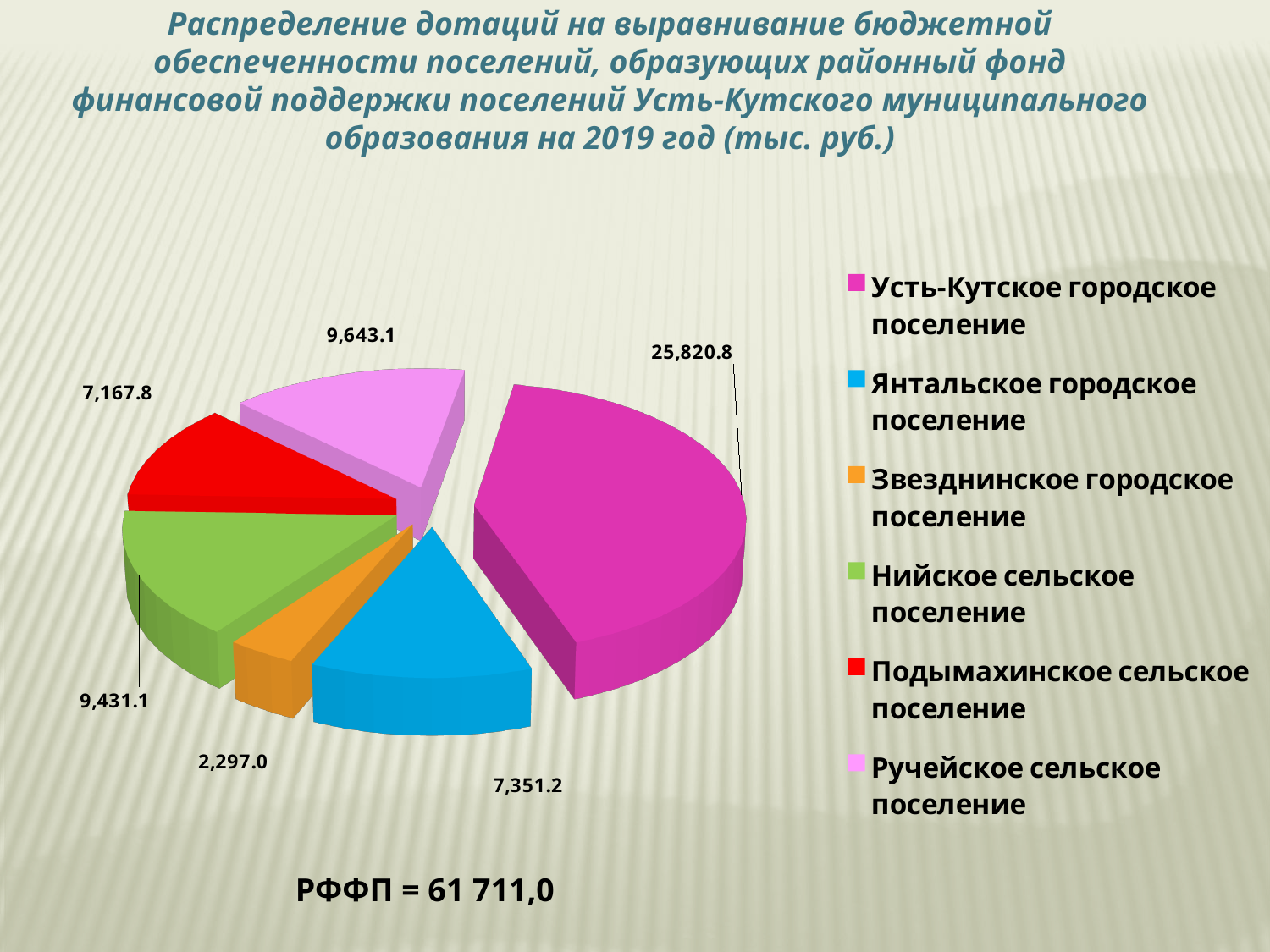
Which settlement receives the largest share of the fund? Усть-Кутское городское поселение What is the value for Нийское сельское поселение? 9,431.1 Which settlement receives the smallest share of the fund? Звезднинское городское поселение How many categories does the legend list? 6 What type of chart is shown on the slide? pie chart What is the value for Янтальское городское поселение? 7,351.2 Which is larger, the value for Ручейское сельское поселение or Нийское сельское поселение? Ручейское сельское поселение What is the value for Усть-Кутское городское поселение? 25,820.8 What is the value for Ручейское сельское поселение? 9,643.1 What is the value for Подымахинское сельское поселение? 7,167.8 What is the value for Звезднинское городское поселение? 2,297.0 What is the difference between the values for Усть-Кутское городское поселение and Янтальское городское поселение? 18,469.6